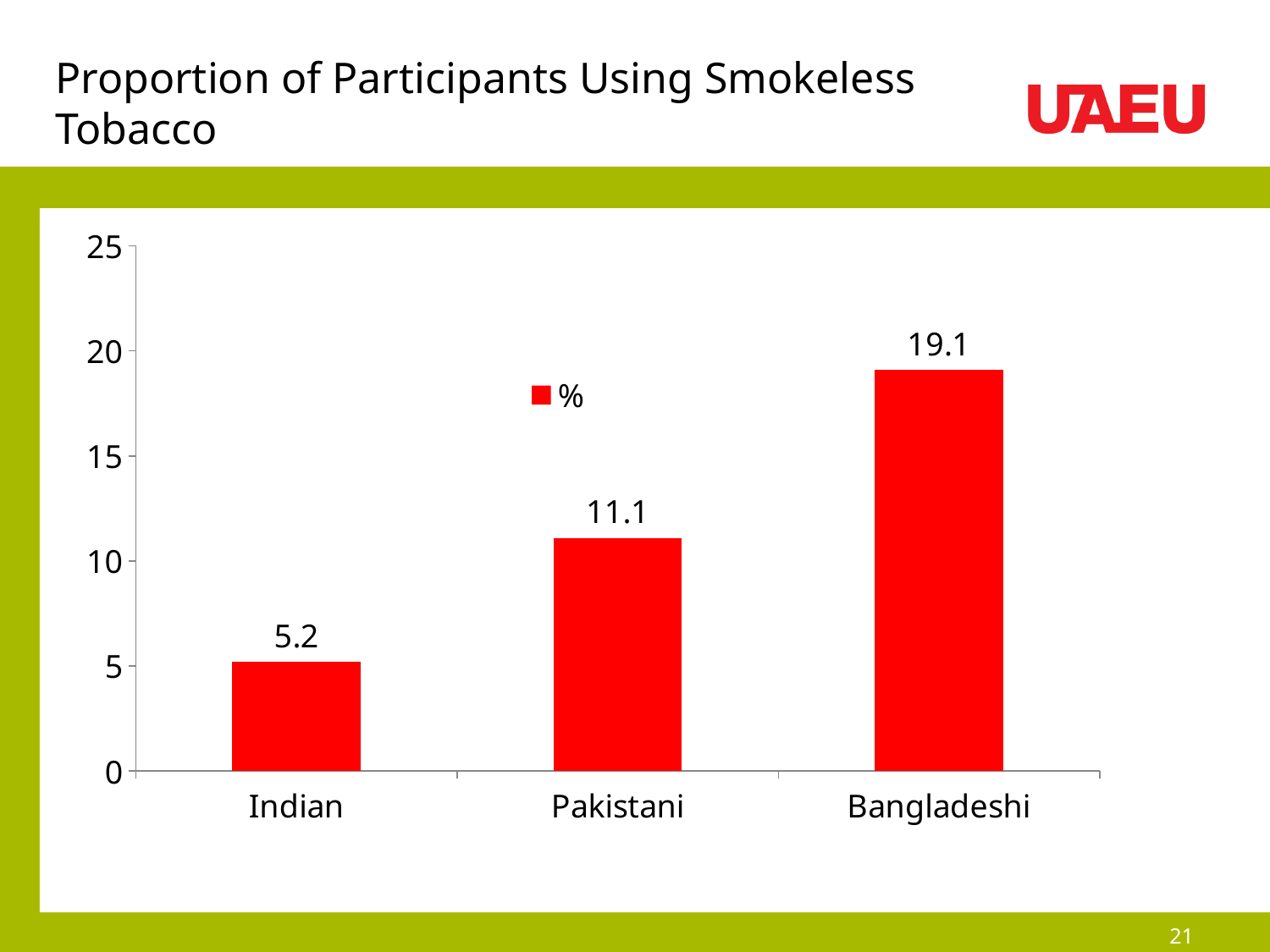
What is the value for Bangladeshi? 19.1 What is the difference between the values for Bangladeshi and Indian? 13.9 What kind of chart is shown on the slide? bar chart What is the value for Pakistani? 11.1 Which is larger, the value for Pakistani or the value for Indian? Pakistani Is the value for Bangladeshi greater or less than 15? greater What is the difference between the values for Pakistani and Indian? 5.9 What is the legend entry shown on the chart? % Which category has the highest value? Bangladeshi Which category has the lowest value? Indian How many categories are shown on the x axis? 3 What is the value for Indian? 5.2